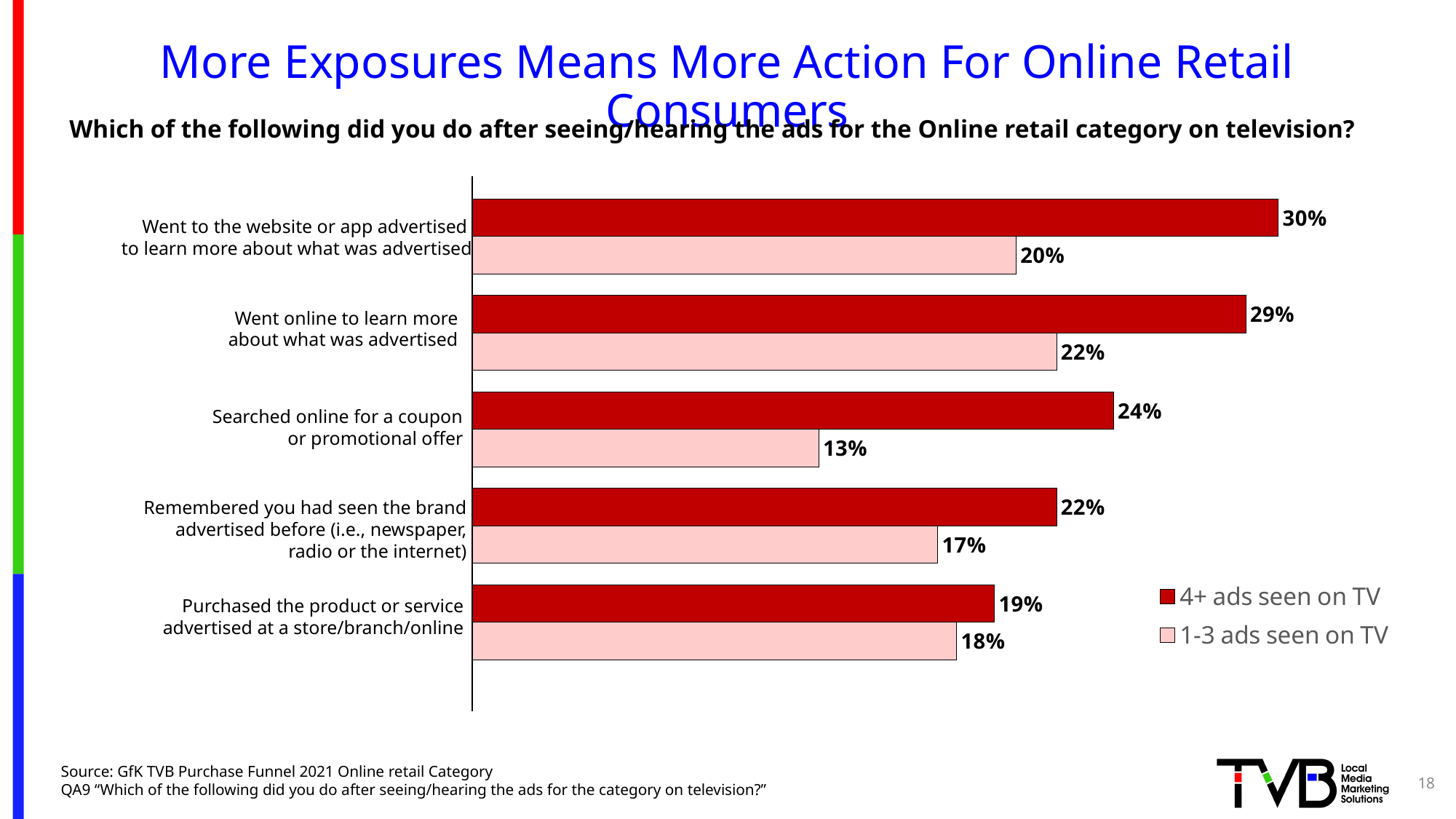
What percentage of respondents who saw 4+ ads on TV went to the website or app advertised to learn more about what was advertised? 30% How many actions (categories) are shown in the chart? 5 What percentage of respondents who saw 1-3 ads on TV searched online for a coupon or promotional offer? 13% What type of chart is shown on the slide? Bar chart How many series does the legend list? 2 Which action has the highest value for the 4+ ads seen on TV series? Went to the website or app advertised to learn more about what was advertised What is the difference between the 4+ ads and 1-3 ads values for 'Went to the website or app advertised to learn more about what was advertised'? 10% What is the difference between the 4+ ads and 1-3 ads values for 'Searched online for a coupon or promotional offer'? 11% Which series is shown in dark red in the chart? 4+ ads seen on TV What is the value for 'Purchased the product or service advertised at a store/branch/online' among those who saw 1-3 ads on TV? 18% Which action has the lowest value for the 1-3 ads seen on TV series? Searched online for a coupon or promotional offer For 'Remembered you had seen the brand advertised before', which series has the larger value: 4+ ads seen on TV or 1-3 ads seen on TV? 4+ ads seen on TV